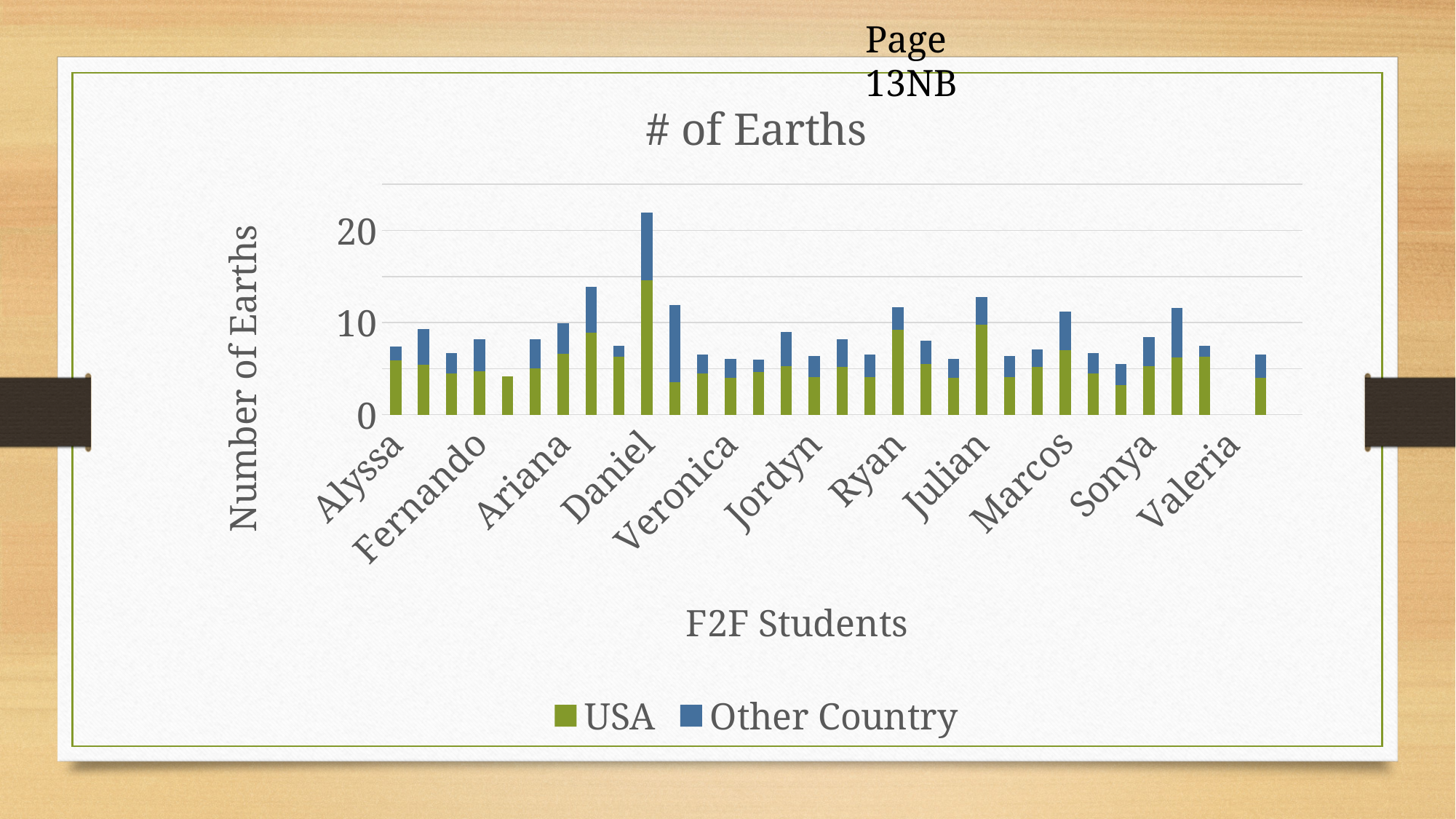
Is the total value for Alyssa greater or less than 10? less How many series does the legend list? 2 What kind of chart is shown on the slide? Stacked bar chart Is the total value for Ryan greater or less than 10? greater Is the total value for Julian greater or less than 10? greater What is the label on the vertical axis? Number of Earths Which has the larger total number of Earths, Daniel or Alyssa? Daniel Which student has the highest total number of Earths? Daniel What is the title of the chart? # of Earths Which has the larger total number of Earths, Julian or Jordyn? Julian